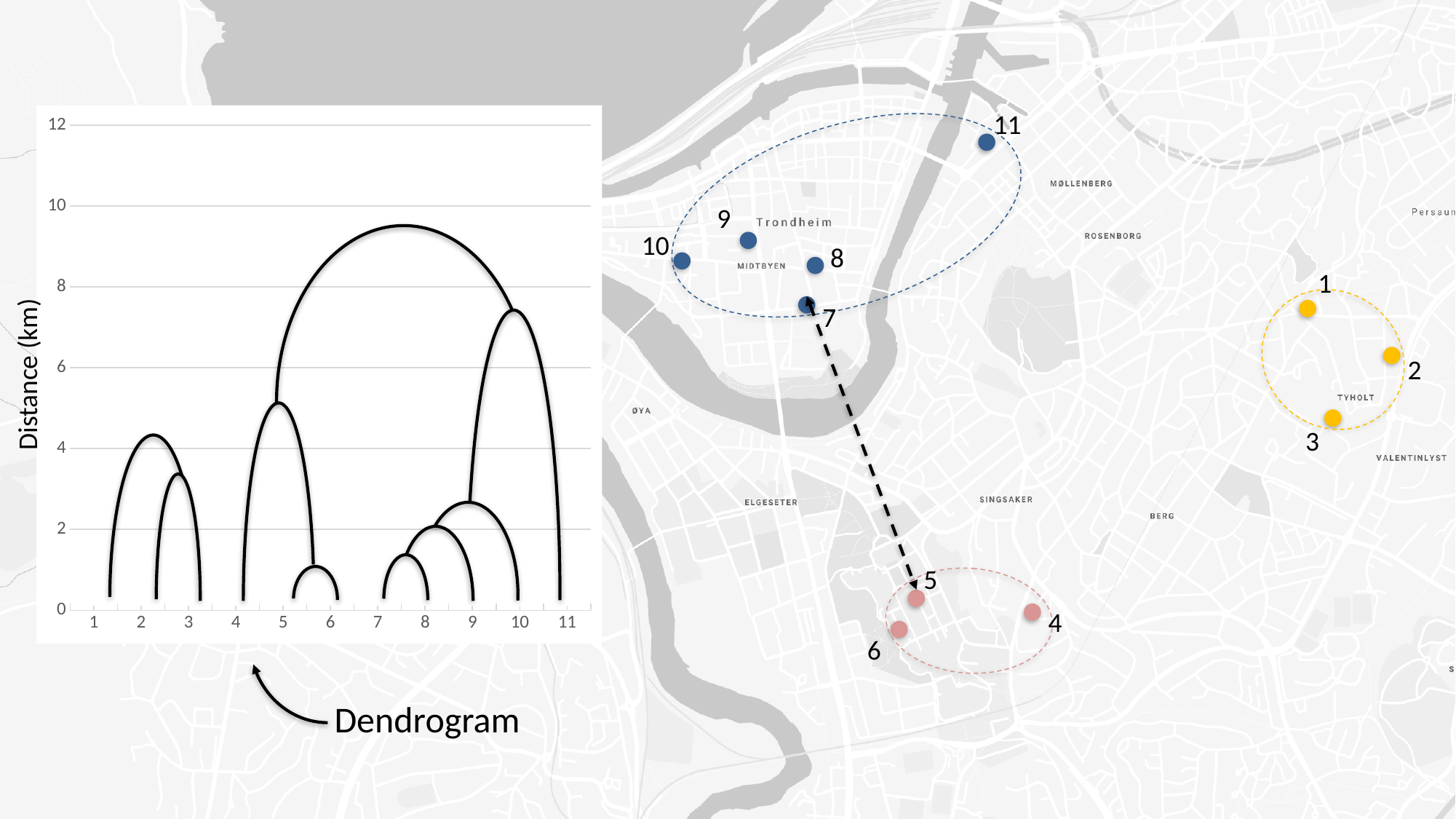
In the dendrogram, which cluster is completed at a greater distance: the cluster of points 1, 2 and 3 or the cluster of points 4, 5 and 6? points 4, 5 and 6 What is the highest tick value shown on the y axis of the dendrogram? 12 What is the label of the y axis of the dendrogram? Distance (km) In the dendrogram, is the distance at which point 4 joins points 5 and 6 greater or less than 4? greater In the dendrogram, is the distance at which points 7 and 8 merge greater or less than 2? less In the dendrogram, is the distance at which point 11 joins the cluster of points 7 to 10 greater or less than 6? greater In the dendrogram, which merge occurs at the highest distance? the final merge joining the cluster of points 1-6 with the cluster of points 7-11 How many leaves (numbered points) are shown along the x axis of the dendrogram? 11 What kind of chart is shown on the left of the slide? dendrogram